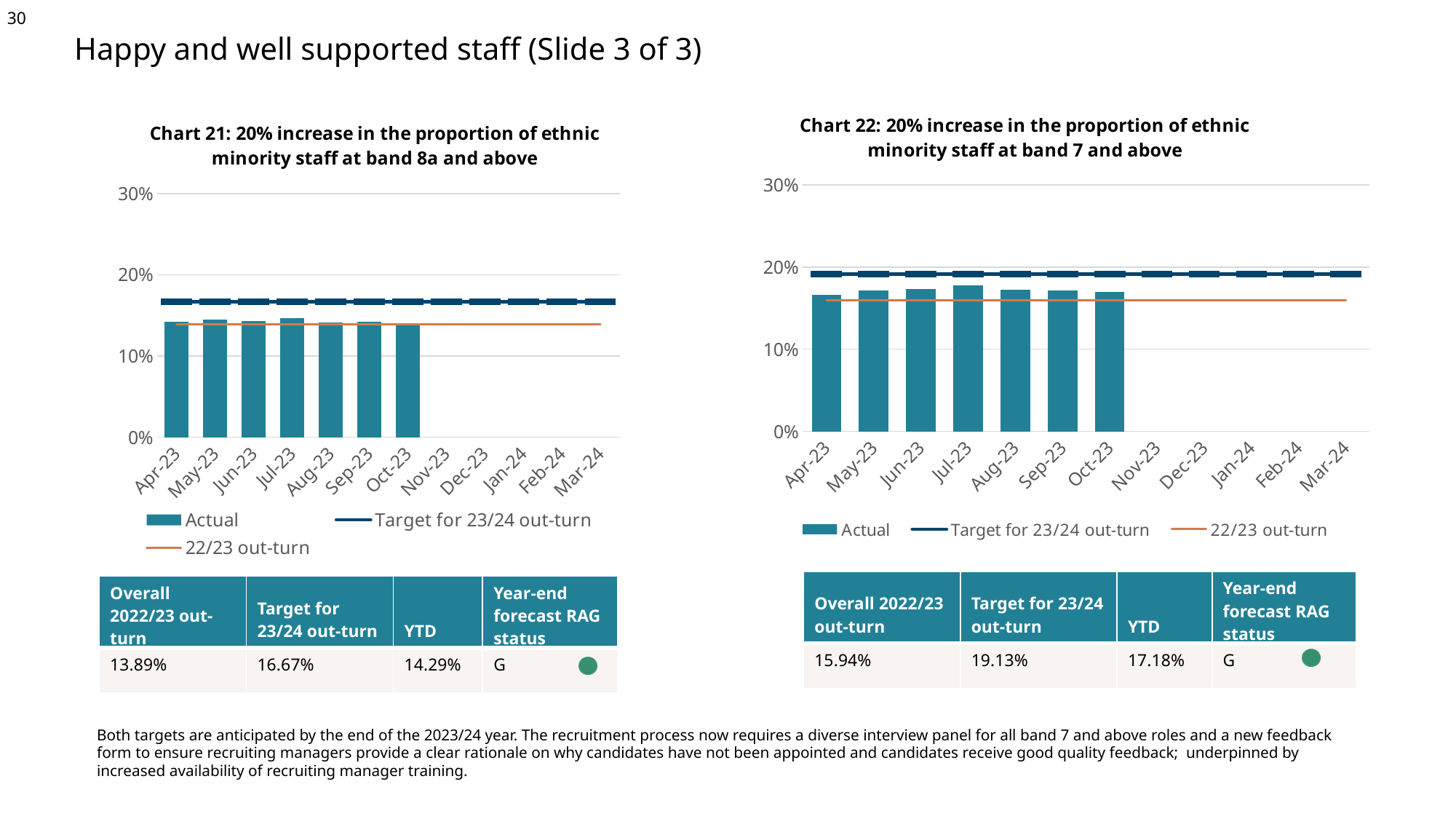
In Chart 22, is the Actual value for Apr-23 greater or less than the 22/23 out-turn line? greater In Chart 22, is the Target for 23/24 out-turn line above or below 20%? below In Chart 21, is the Actual value for Apr-23 greater or less than 20%? less In Chart 21, is the Actual value for Jul-23 greater or less than 10%? greater In Chart 22, which month has the lowest Actual bar? Apr-23 In Chart 22, how many months have an Actual bar plotted? 7 What is the title of the chart on the right of the slide? Chart 22: 20% increase in the proportion of ethnic minority staff at band 7 and above In Chart 22, which month has the highest Actual bar? Jul-23 In Chart 21, which is the last month with an Actual bar plotted? Oct-23 What kind of chart is Chart 21? combination bar and line chart How many series does the legend of Chart 22 list? 3 How many months are shown on the x axis of Chart 21? 12